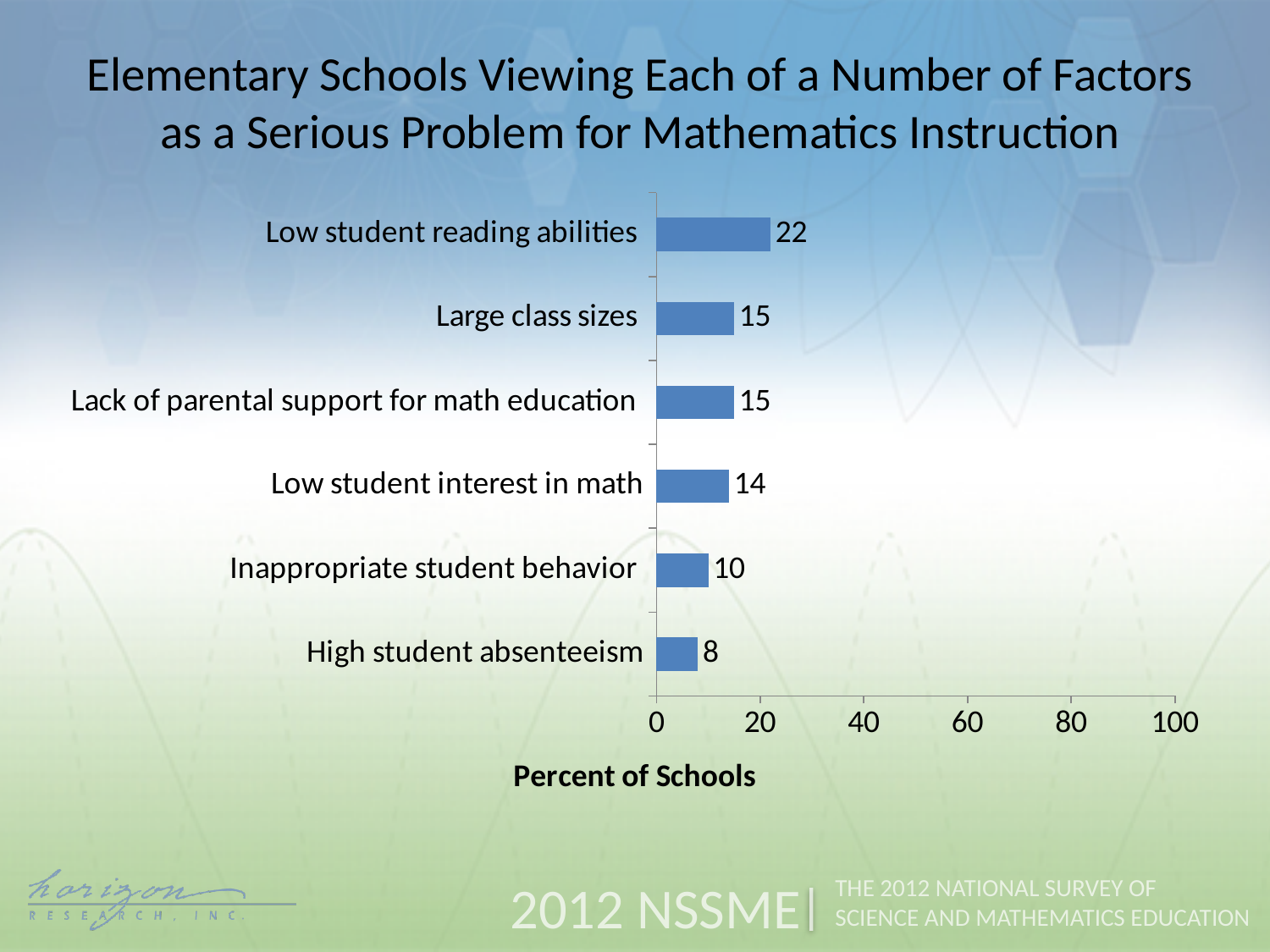
Which is larger, the value for Large class sizes or the value for Inappropriate student behavior? Large class sizes What is the value for Inappropriate student behavior? 10 Which factor has the highest percent of schools? Low student reading abilities Which factor has the lowest percent of schools? High student absenteeism What is the difference between the values for Low student reading abilities and High student absenteeism? 14 What percent of schools view low student reading abilities as a serious problem? 22 What kind of chart is shown on the slide? Bar chart What is the label of the horizontal axis? Percent of Schools What is the difference between the values for Low student interest in math and Inappropriate student behavior? 4 What is the value for High student absenteeism? 8 Is the value for Low student reading abilities greater or less than 20? greater How many factors are shown in the chart? 6